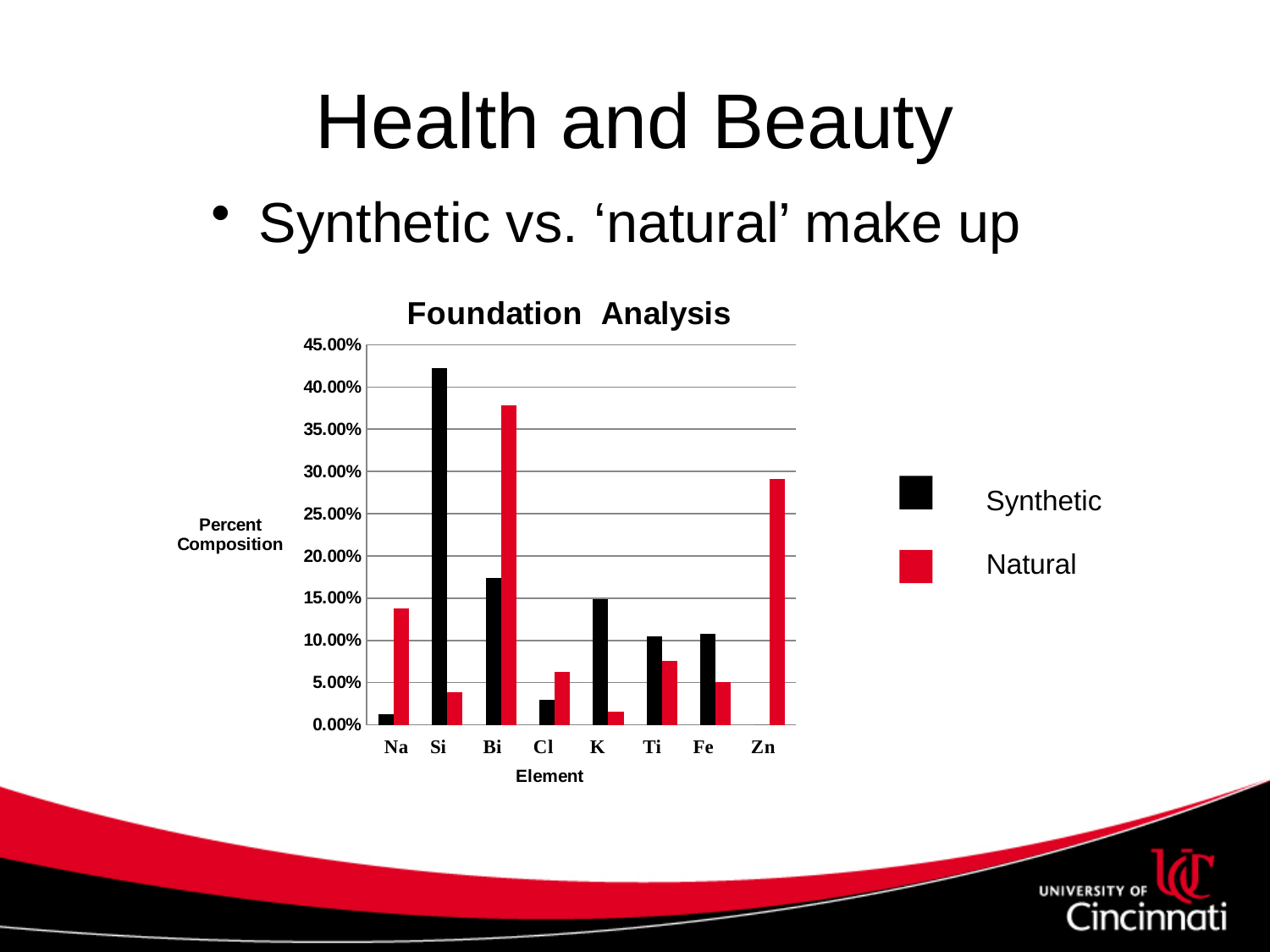
For Na, which is larger: the Synthetic value or the Natural value? Natural What is the title of the chart on the slide? Foundation Analysis For Si, which is larger: the Synthetic value or the Natural value? Synthetic Is the Natural value for Zn greater or less than 30.00%? less How many series does the legend of the Foundation Analysis chart list? 2 What kind of chart is shown on the slide? bar chart Which element has the highest Synthetic value in the Foundation Analysis chart? Si What colour represents the Natural series in the chart? red Which element has the highest Natural value in the Foundation Analysis chart? Bi Is the Synthetic value for Si greater or less than 40.00%? greater Which element has the lowest Natural value in the Foundation Analysis chart? K How many elements are shown on the x axis of the Foundation Analysis chart? 8